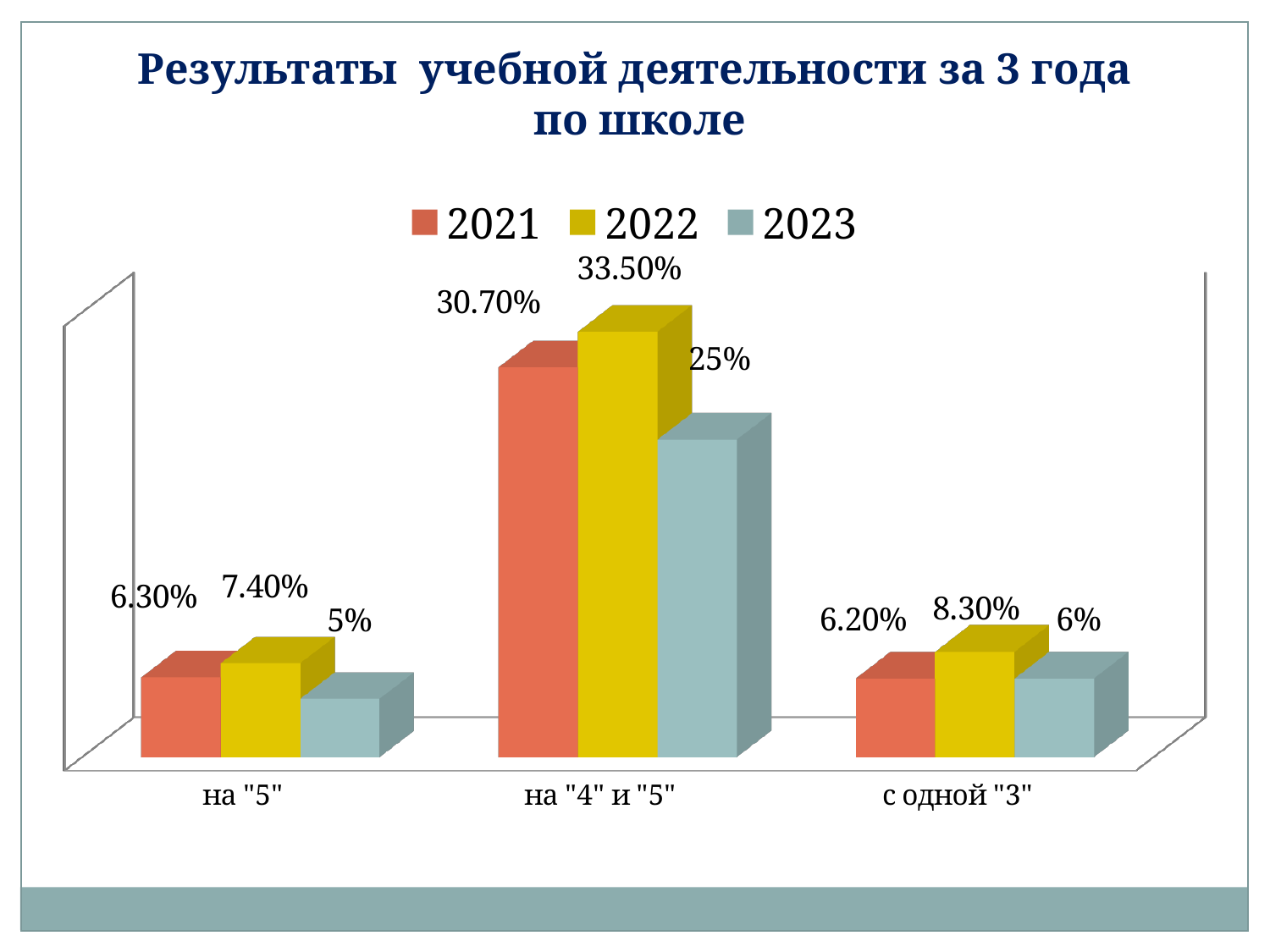
Which is larger: the 2021 value for на "5" or the 2021 value for с одной "3"? на "5" How many series does the legend list? 3 What is the value for 2021 in the category с одной "3"? 6.20% What is the difference between the 2022 and 2021 values in the category с одной "3"? 2.10% What is the value for 2022 in the category на "4" и "5"? 33.50% What is the value for 2023 in the category на "5"? 5% What is the difference between the 2022 and 2023 values in the category на "4" и "5"? 8.50% Which year has the lowest value in the category на "5"? 2023 What kind of chart is shown on the slide? Bar chart Which colour represents the 2022 series in the legend? Yellow Which year has the highest value in the category на "4" и "5"? 2022 How many categories are shown on the x axis? 3